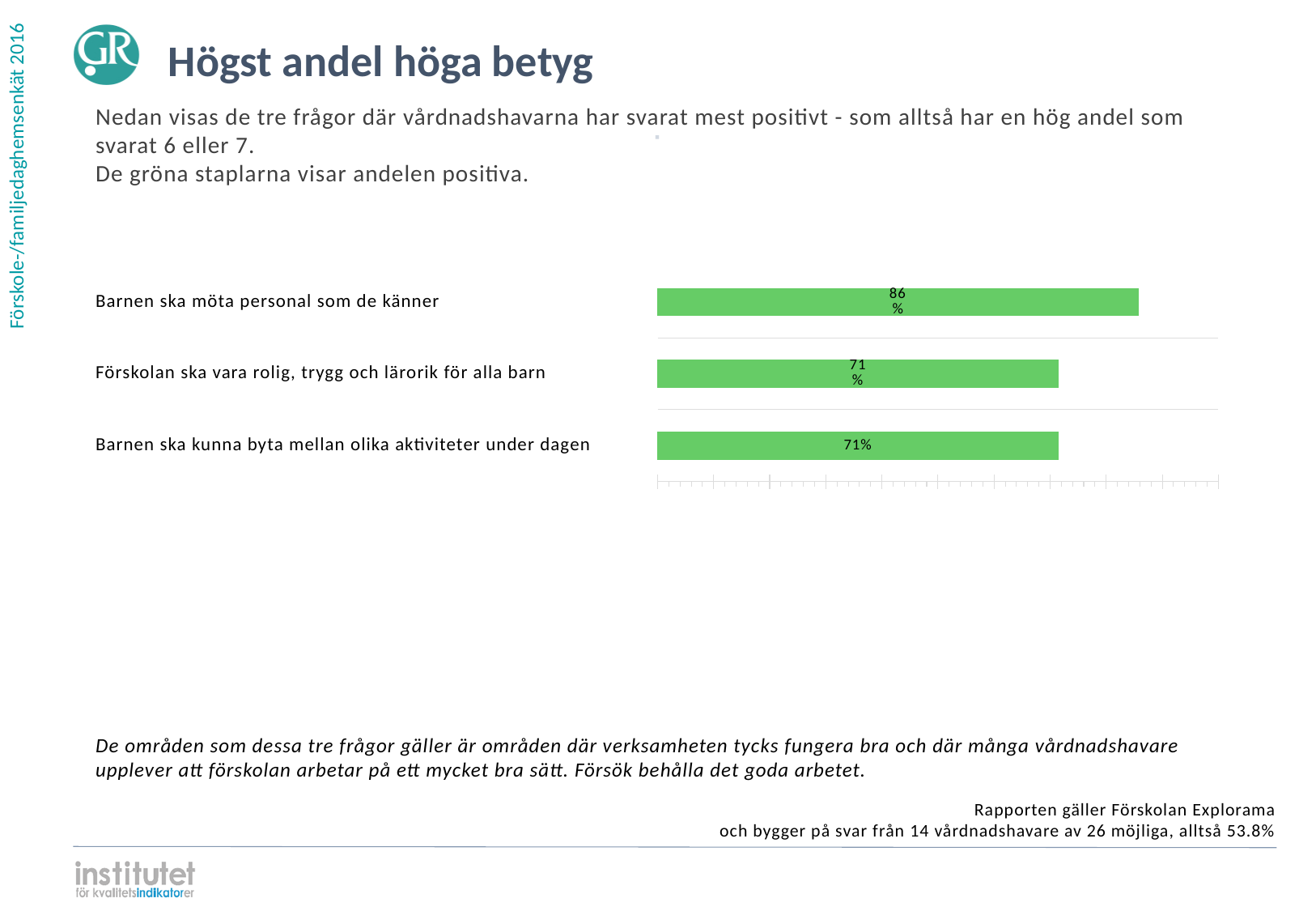
What kind of chart is shown on the slide? Bar chart What is the difference between the value for "Barnen ska möta personal som de känner" and the value for "Förskolan ska vara rolig, trygg och lärorik för alla barn"? 15 percentage points What is the value for "Barnen ska möta personal som de känner"? 86% What is the value for "Förskolan ska vara rolig, trygg och lärorik för alla barn"? 71% How many categories are shown in the chart? 3 What is the title of the slide containing the chart? Högst andel höga betyg What is the value for "Barnen ska kunna byta mellan olika aktiviteter under dagen"? 71% Which is larger: the value for "Barnen ska möta personal som de känner" or the value for "Barnen ska kunna byta mellan olika aktiviteter under dagen"? Barnen ska möta personal som de känner Which category has the highest value? Barnen ska möta personal som de känner What colour are the bars in the chart? Green